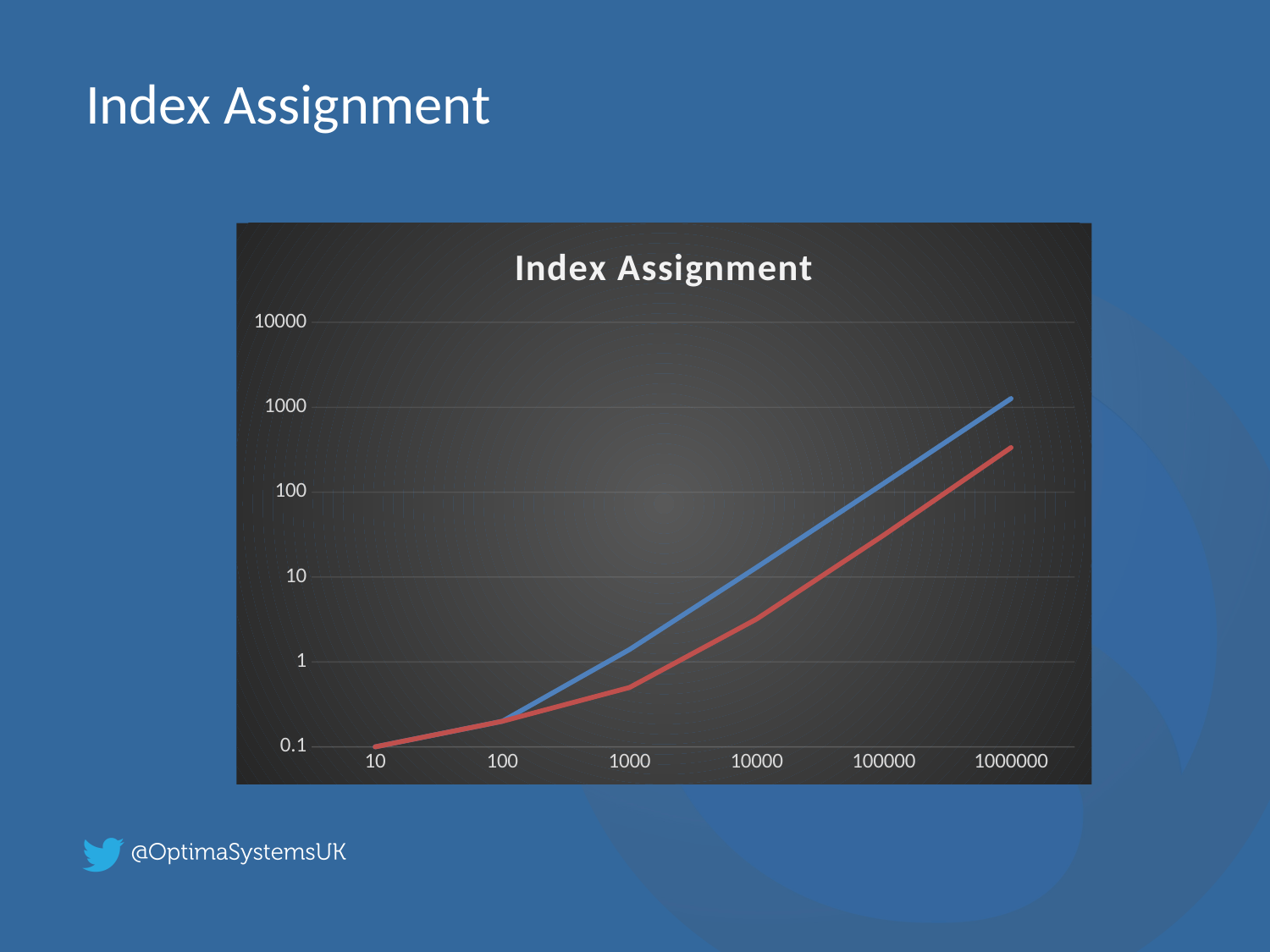
Is the value of the red line at x = 100000 greater or less than 100? less Is the value of the red line at x = 1000000 greater or less than 100? greater How many tick labels are shown on the x axis? 6 At x = 1000000, which line has the higher value, the blue line or the red line? blue line Do the values of the red line rise or fall as the x axis increases from 10 to 1000000? rise What kind of chart is shown on the slide? line chart Is the value of the red line at x = 1000 greater or less than 1? less At which x-axis value does the blue line reach its highest point? 1000000 What is the title of the chart? Index Assignment How many lines are plotted on the chart? 2 At x = 10000, which line has the higher value, the blue line or the red line? blue line Do the values of the blue line rise or fall as the x axis increases from 10 to 1000000? rise